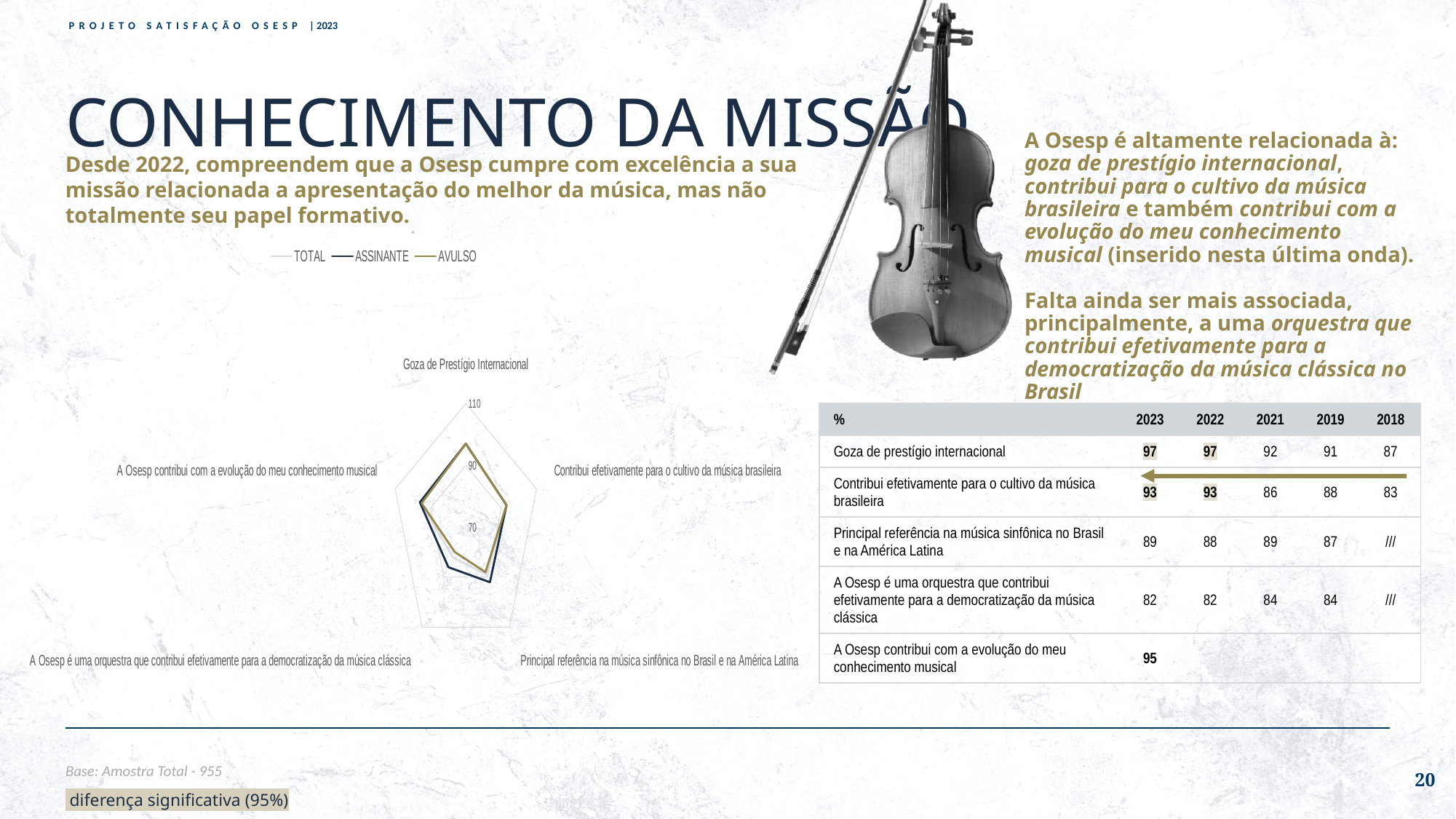
Is the value for 'Goza de Prestígio Internacional' greater or less than 110? less What kind of chart is shown on the slide? radar chart How many series does the chart's legend list? 3 What is the highest axis tick value shown on the radar chart? 110 Is the value for 'Goza de Prestígio Internacional' greater or less than 90? greater Which series in the chart legend is drawn in dark navy blue? ASSINANTE What are the three series named in the chart legend? TOTAL, ASSINANTE, AVULSO Is the value for 'Contribui efetivamente para o cultivo da música brasileira' greater or less than 110? less How many categories (axes) does the radar chart have? 5 Which category has the lowest value on the radar chart? A Osesp é uma orquestra que contribui efetivamente para a democratização da música clássica